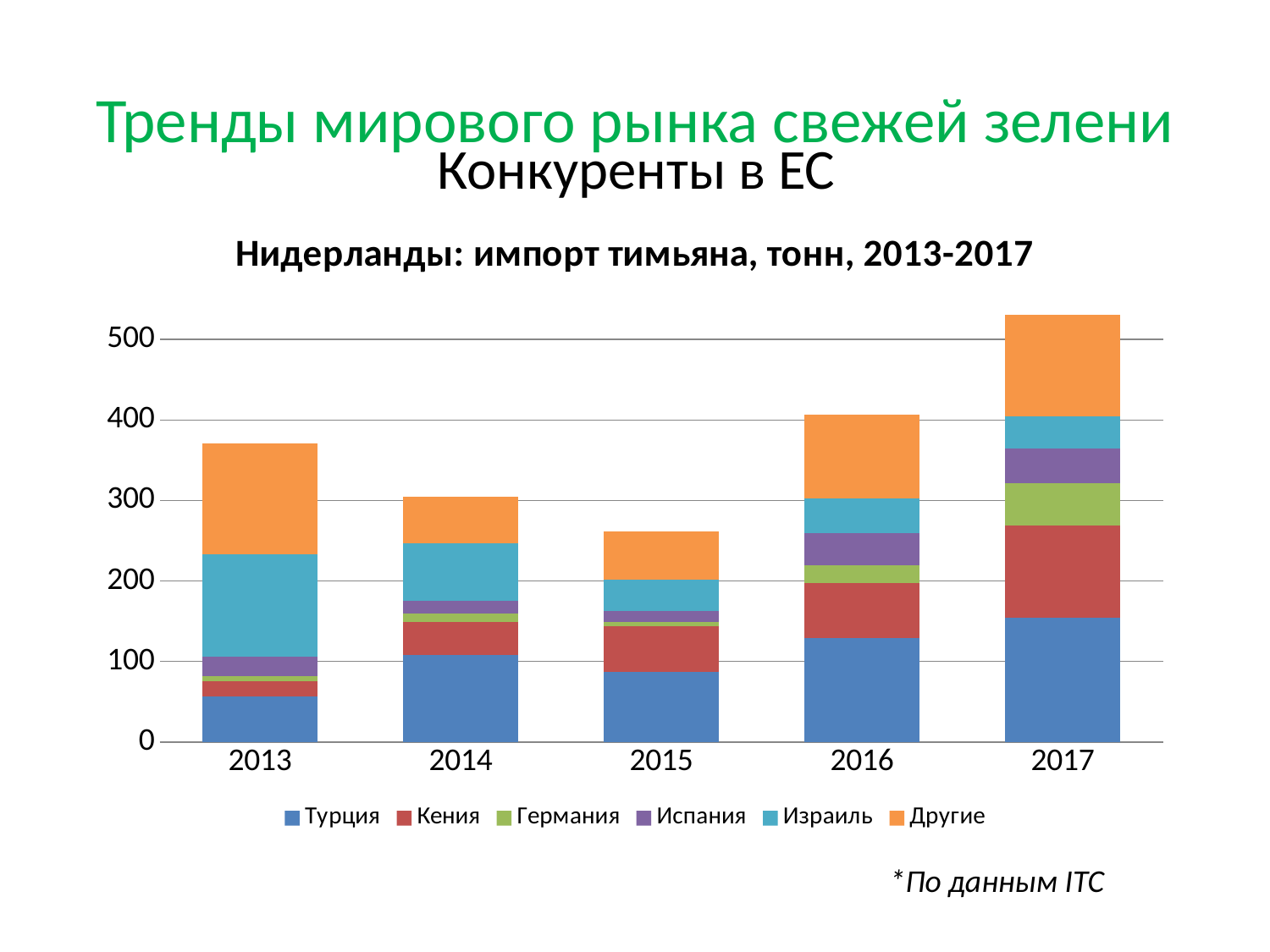
What is the title of the chart? Нидерланды: импорт тимьяна, тонн, 2013-2017 Do the total imports rise or fall from 2015 to 2017? rise Is the value for Турция in 2017 greater or less than 100? greater Is the total for 2015 greater or less than 300? less How many series does the legend list? 6 Is the total for 2017 greater or less than 500? greater Which year has the larger total import, 2013 or 2017? 2017 What kind of chart is shown on the slide? Stacked bar chart Which year has the highest total import? 2017 How many years are shown on the x axis? 5 Which year has the lowest total import? 2015 Which series is shown in orange in the legend? Другие